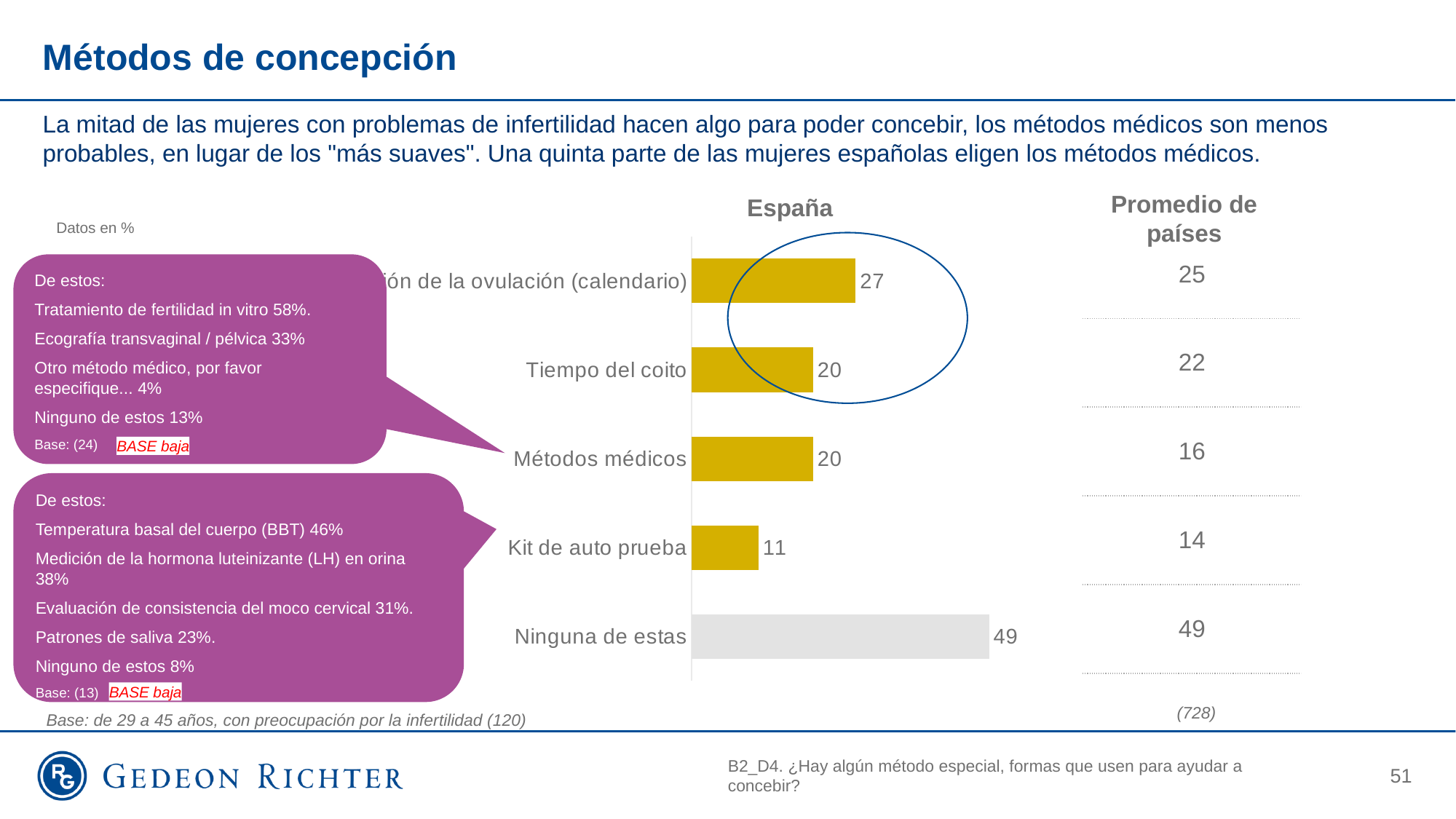
In the España bar chart, what is the value for Métodos médicos? 20 In the España bar chart, what is the value for Tiempo del coito? 20 In the España bar chart, which category has the lowest value? Kit de auto prueba In the España bar chart, which category has the highest value? Ninguna de estas In the España bar chart, what is the difference between the values for Ninguna de estas and Kit de auto prueba? 38 In the España bar chart, what is the value for Ninguna de estas? 49 What is the Promedio de países value for Métodos médicos? 16 In the España bar chart, which is larger: the value for Métodos médicos or the value for Kit de auto prueba? Métodos médicos In the España bar chart, what is the value for Kit de auto prueba? 11 What kind of chart is used to show the España data? Bar chart How many categories are shown in the España bar chart? 5 What is the difference between the España value and the Promedio de países value for Métodos médicos? 4